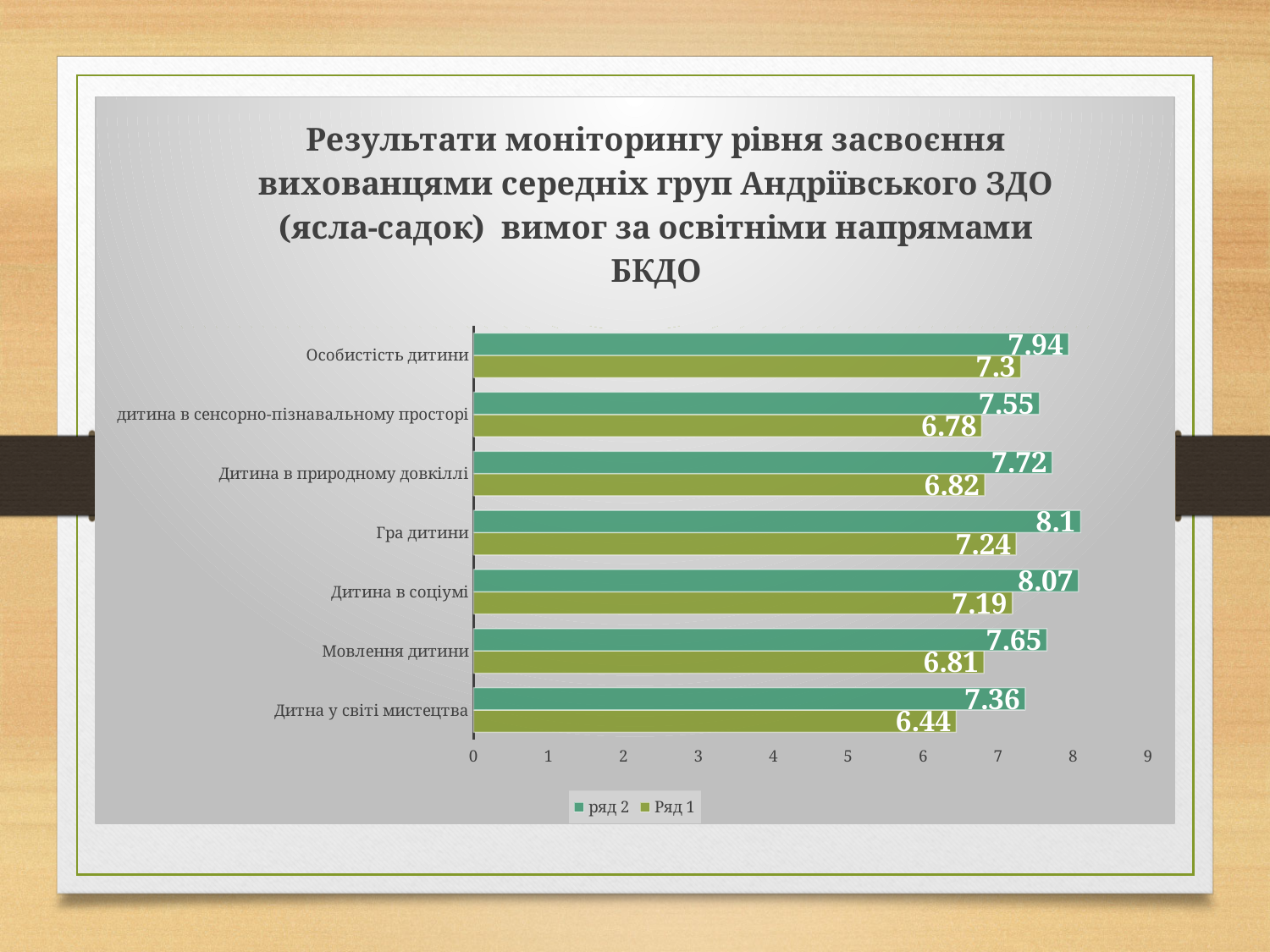
What is the value of Ряд 1 for Дитна у світі мистецтва? 6.44 What is the value of ряд 2 for Мовлення дитини? 7.65 What is the value of Ряд 1 for Особистість дитини? 7.3 Which is larger for Дитина в природному довкіллі: ряд 2 or Ряд 1? ряд 2 What type of chart is shown on the slide? bar chart What is the difference between ряд 2 and Ряд 1 for Дитина в соціумі? 0.88 Which category has the lowest value for ряд 2? Дитна у світі мистецтва How many categories are shown on the chart? 7 What is the value of ряд 2 for Гра дитини? 8.1 Which category has the lowest value for Ряд 1? Дитна у світі мистецтва How many series does the legend list? 2 Which series is shown in the teal colour in the legend? ряд 2